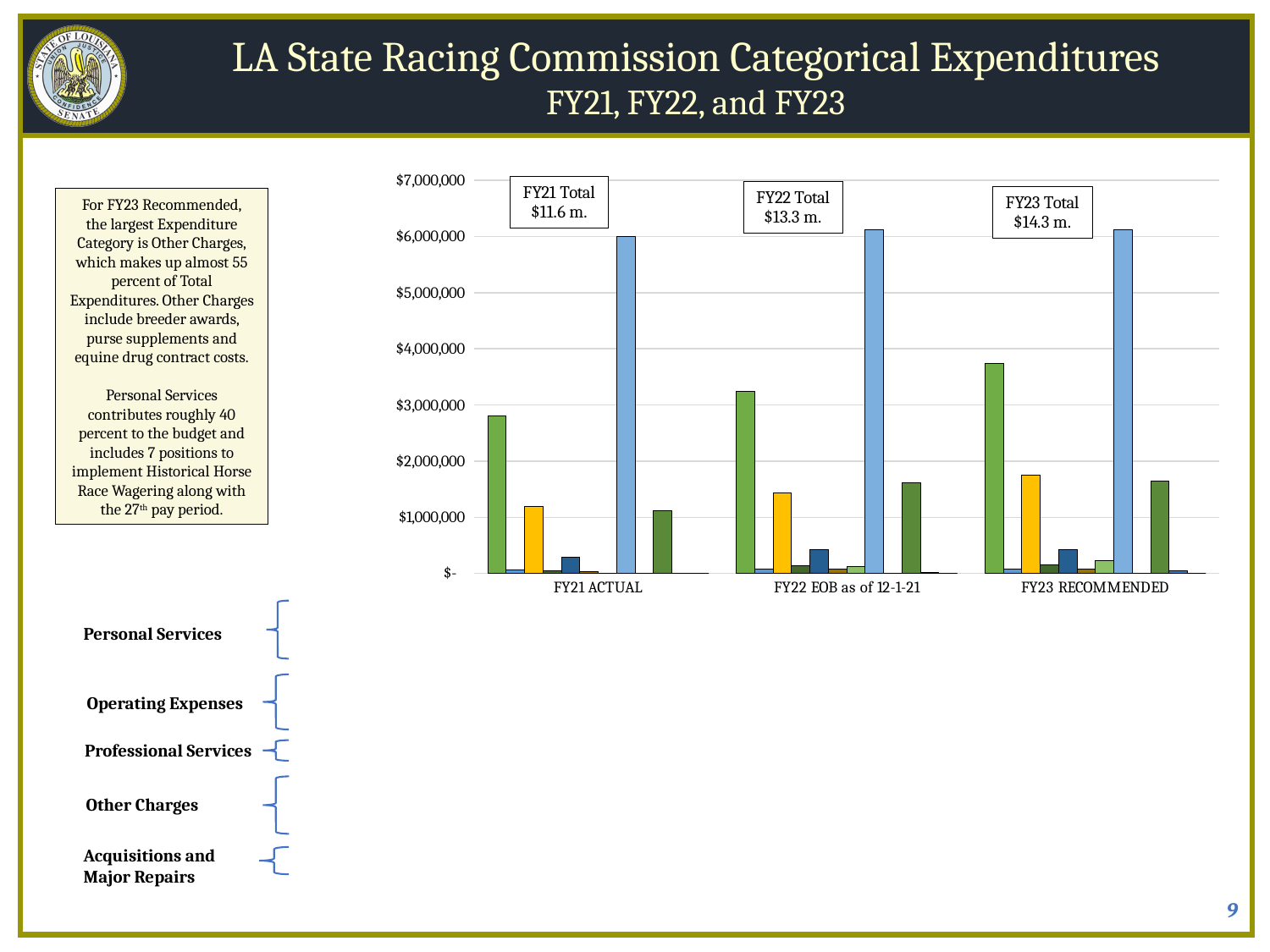
Is the value of the light green bar in the FY21 ACTUAL group greater or less than $2,000,000? greater What is the highest value shown on the chart's vertical axis? $7,000,000 What is the FY23 Total shown in the text box on the chart? $14.3 m. Is the light green bar larger in the FY21 ACTUAL group or in the FY23 RECOMMENDED group? FY23 RECOMMENDED How many fiscal-year categories are shown along the x axis of the chart? 3 What kind of chart is shown on the slide? bar chart Which fiscal year has the highest total expenditures according to the text boxes on the chart? FY23 Is the value of the light green bar in the FY23 RECOMMENDED group greater or less than $3,000,000? greater What is the FY21 Total shown in the text box on the chart? $11.6 m. Which fiscal year has the lowest total expenditures according to the text boxes on the chart? FY21 What is the difference between the FY23 Total and the FY21 Total shown on the chart? $2.7 m. What is the FY22 Total shown in the text box on the chart? $13.3 m.